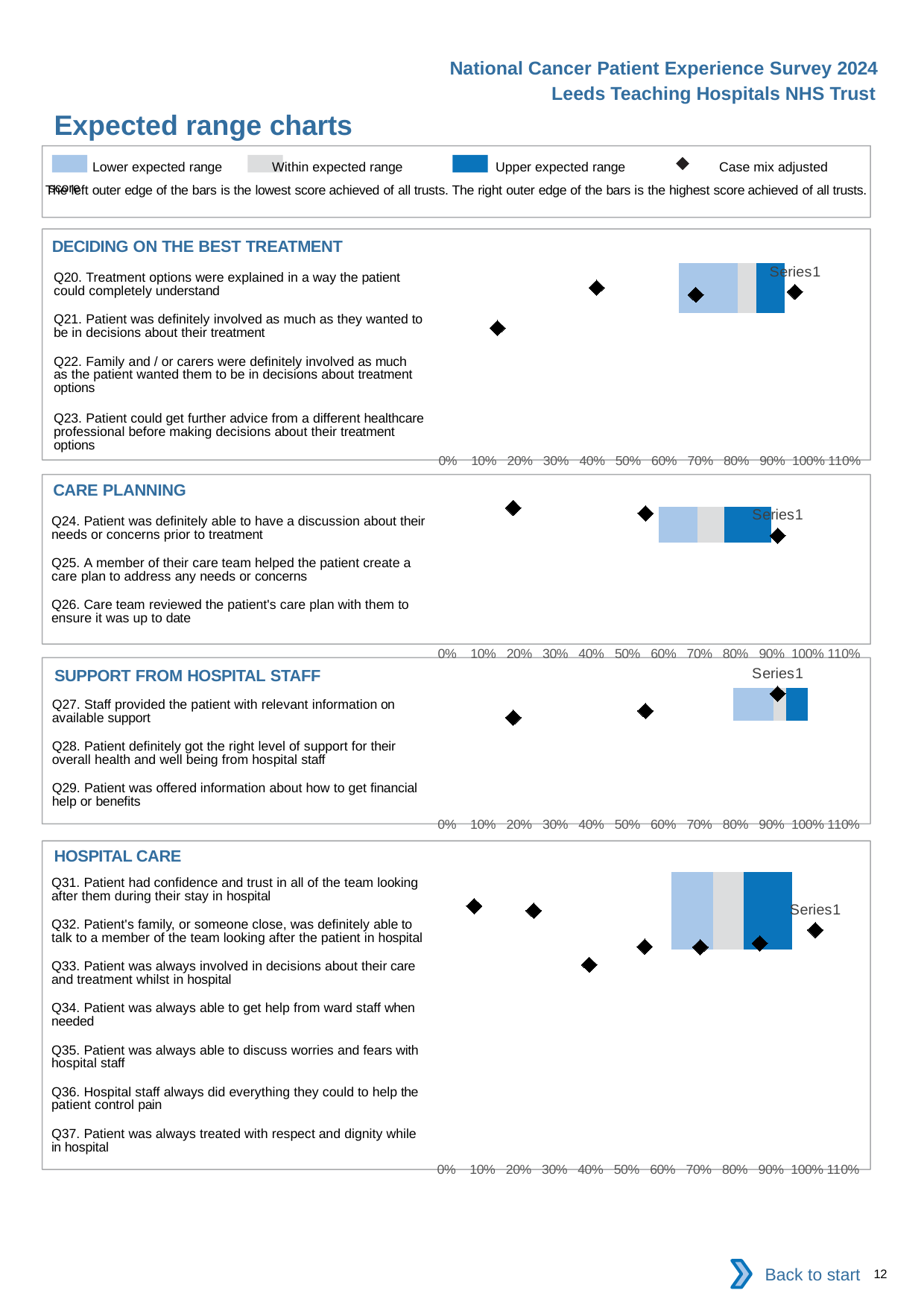
How many entries does the legend at the top of the slide list? 4 According to the legend, what does the dark blue colour represent? Upper expected range How many question categories are listed in the 'SUPPORT FROM HOSPITAL STAFF' chart? 3 What is the highest tick label on the x axis of the 'HOSPITAL CARE' chart? 110% How many question categories are listed in the 'CARE PLANNING' chart? 3 How many expected range charts are shown on the slide? 4 What kind of chart is used in the 'DECIDING ON THE BEST TREATMENT' section? bar chart What is the lowest tick label on the x axis of the 'CARE PLANNING' chart? 0%